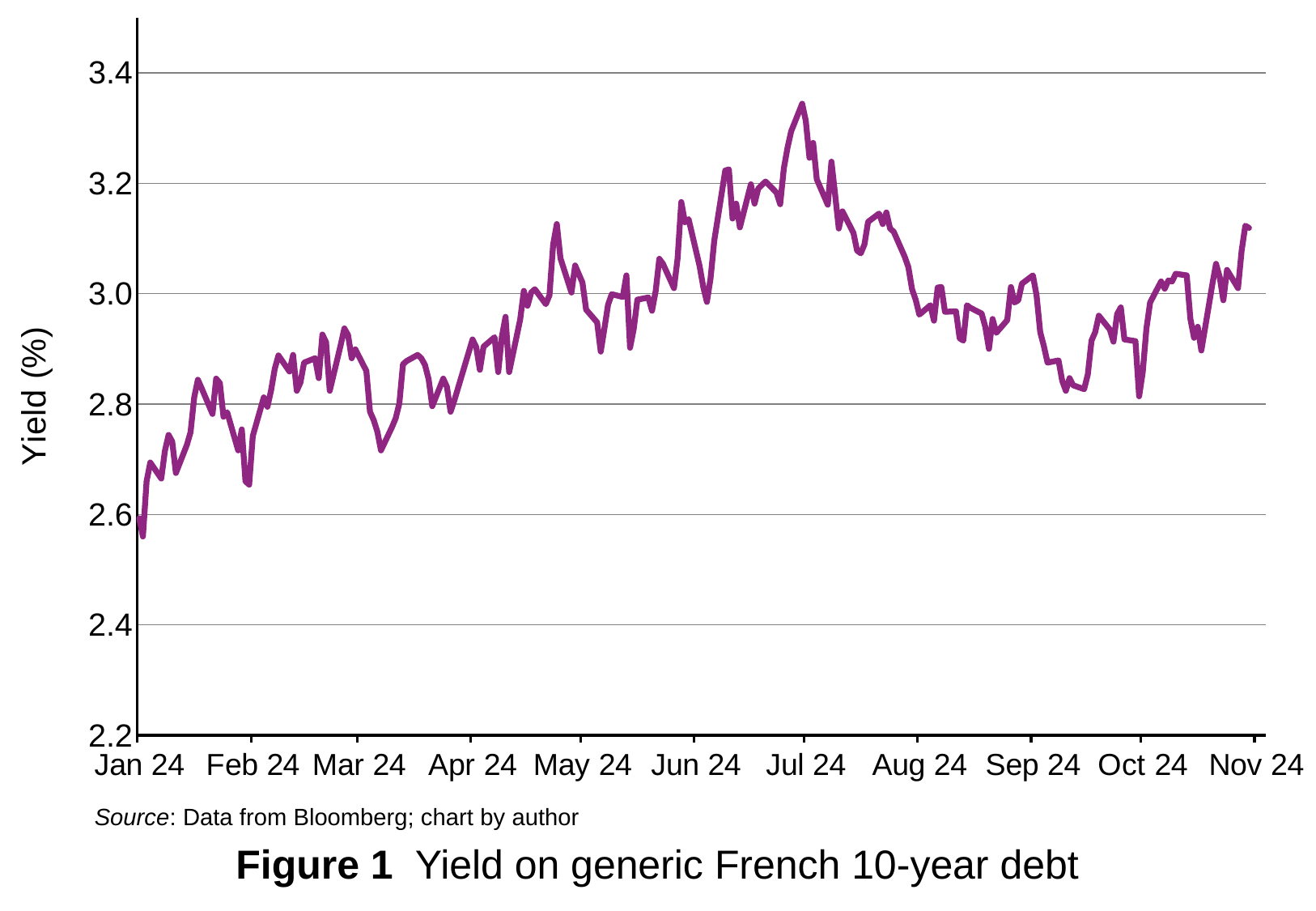
What kind of chart is shown in Figure 1? line chart Does the yield generally rise or fall from Jan 24 to Jul 24? rise Is the yield at Nov 24 greater or less than 3.0? greater Is the yield at the start of Jan 24 greater or less than 2.8? less Is the yield at Apr 24 greater or less than 3.0? less What is the title of Figure 1? Yield on generic French 10-year debt Around which month label does the yield reach its highest point? Jul 24 How many month labels are shown on the x-axis? 11 What is the label on the y-axis of the chart? Yield (%) Around which month label does the yield reach its lowest point? Jan 24